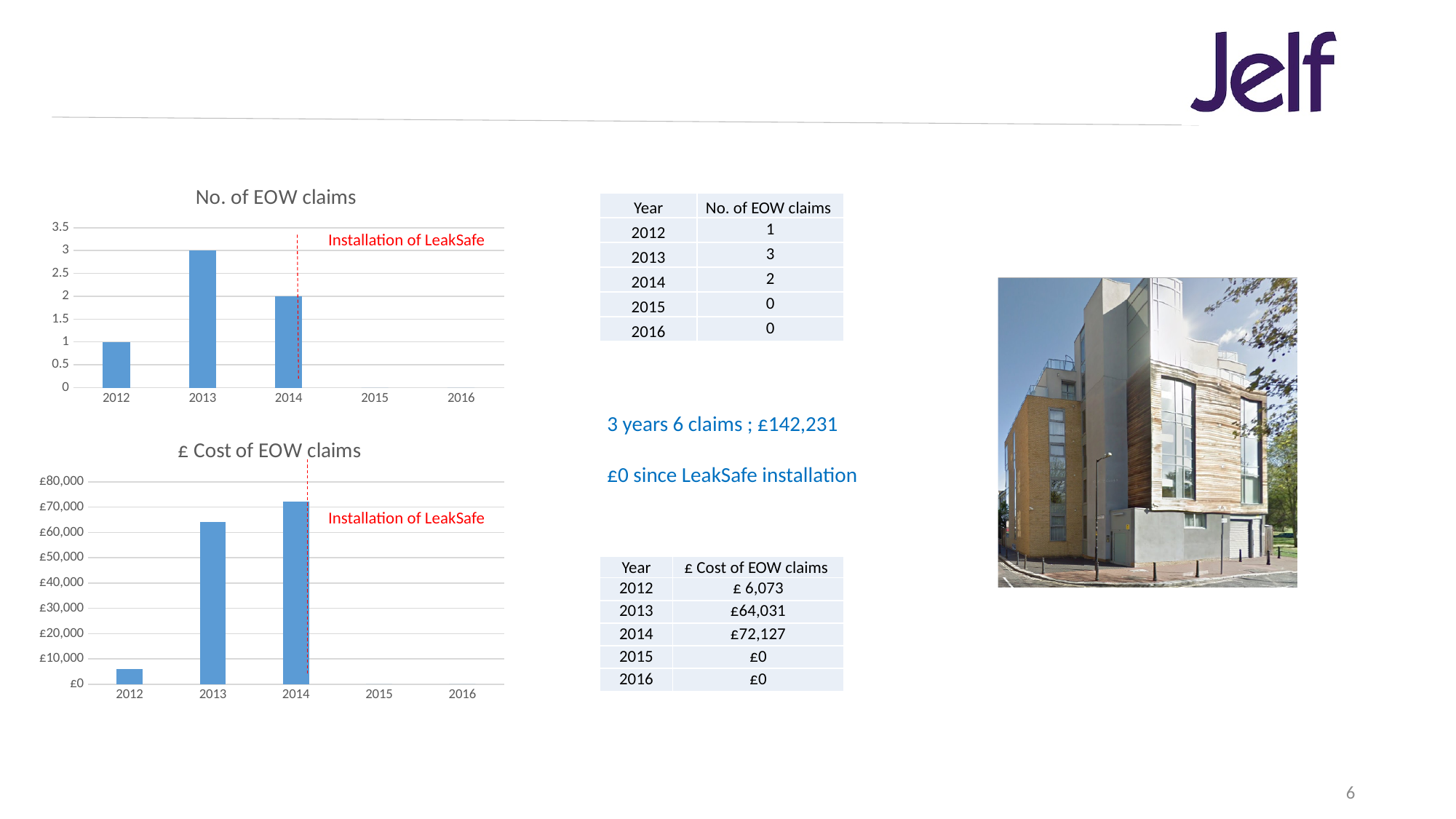
In the 'No. of EOW claims' chart, how many years are shown on the x axis? 5 In the 'No. of EOW claims' chart, what is the value for 2013? 3 In the '£ Cost of EOW claims' chart, is the value for 2012 greater or less than £10,000? less In the '£ Cost of EOW claims' chart, is the value for 2013 greater or less than £60,000? greater In the '£ Cost of EOW claims' chart, which is larger, the value for 2013 or the value for 2014? 2014 In the 'No. of EOW claims' chart, what is the value for 2014? 2 What does the red dashed vertical line in the 'No. of EOW claims' chart mark? Installation of LeakSafe In the '£ Cost of EOW claims' chart, which year has the highest cost? 2014 What kind of chart is the '£ Cost of EOW claims' chart? Bar chart In the '£ Cost of EOW claims' chart, what is the cost for 2014 as shown in the accompanying table? £72,127 In the 'No. of EOW claims' chart, what is the difference between the values for 2013 and 2012? 2 In the 'No. of EOW claims' chart, which year has the highest number of claims? 2013